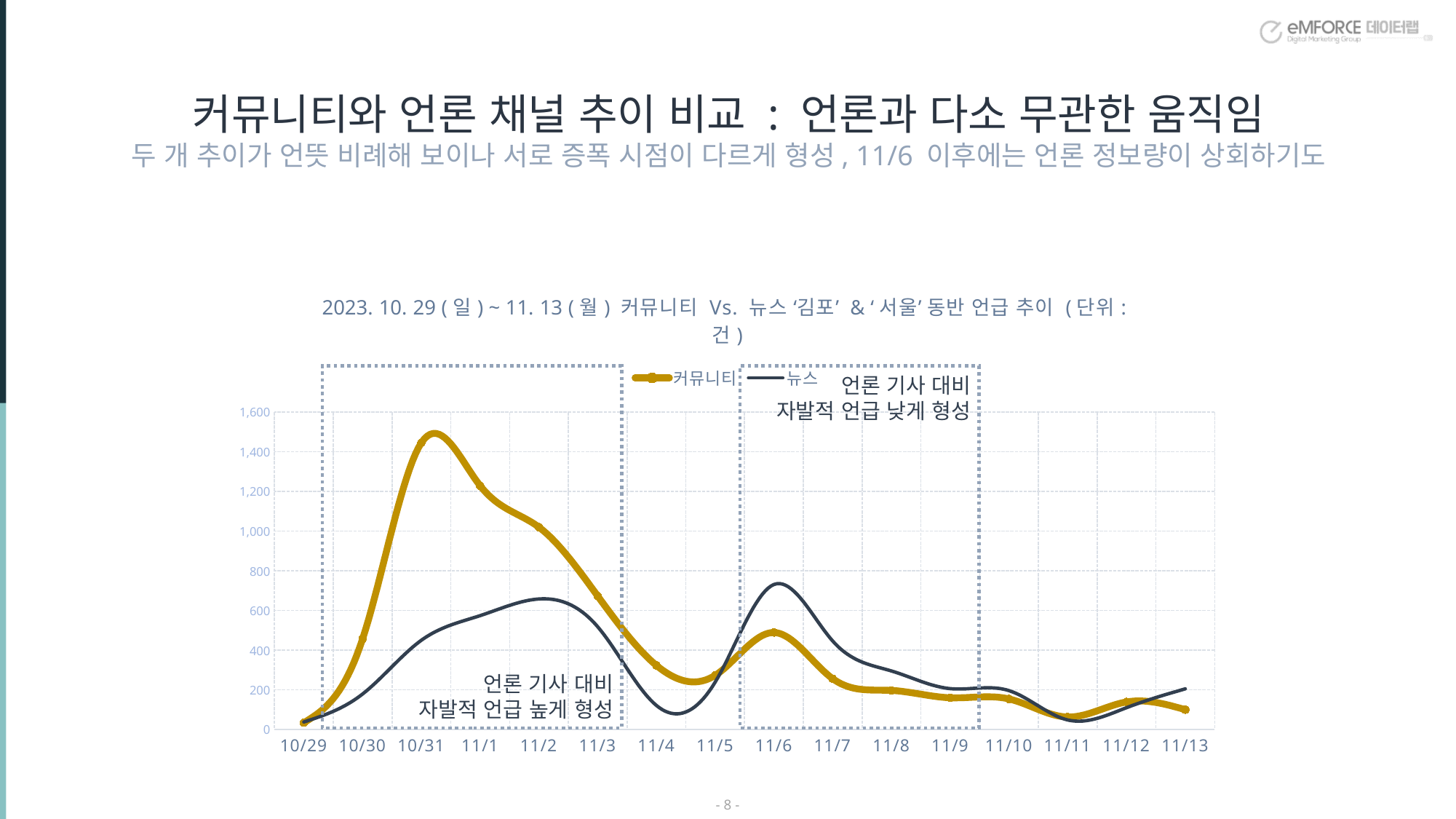
On 11/6, which series has the larger value, 커뮤니티 or 뉴스? 뉴스 What kind of chart is shown on the slide? line chart On 10/31, which series has the larger value, 커뮤니티 or 뉴스? 커뮤니티 How many dates are shown along the x axis? 16 On which date does the 뉴스 series reach its highest value? 11/6 Is the value for 뉴스 on 11/6 greater or less than 600? greater Is the value for 커뮤니티 on 11/4 greater or less than 400? less On which date does the 커뮤니티 series reach its highest value? 10/31 Does the 커뮤니티 series rise or fall from 10/31 to 11/4? fall How many series does the legend list? 2 Is the value for 커뮤니티 on 10/31 greater or less than 1,400? greater What are the two series named in the legend? 커뮤니티, 뉴스